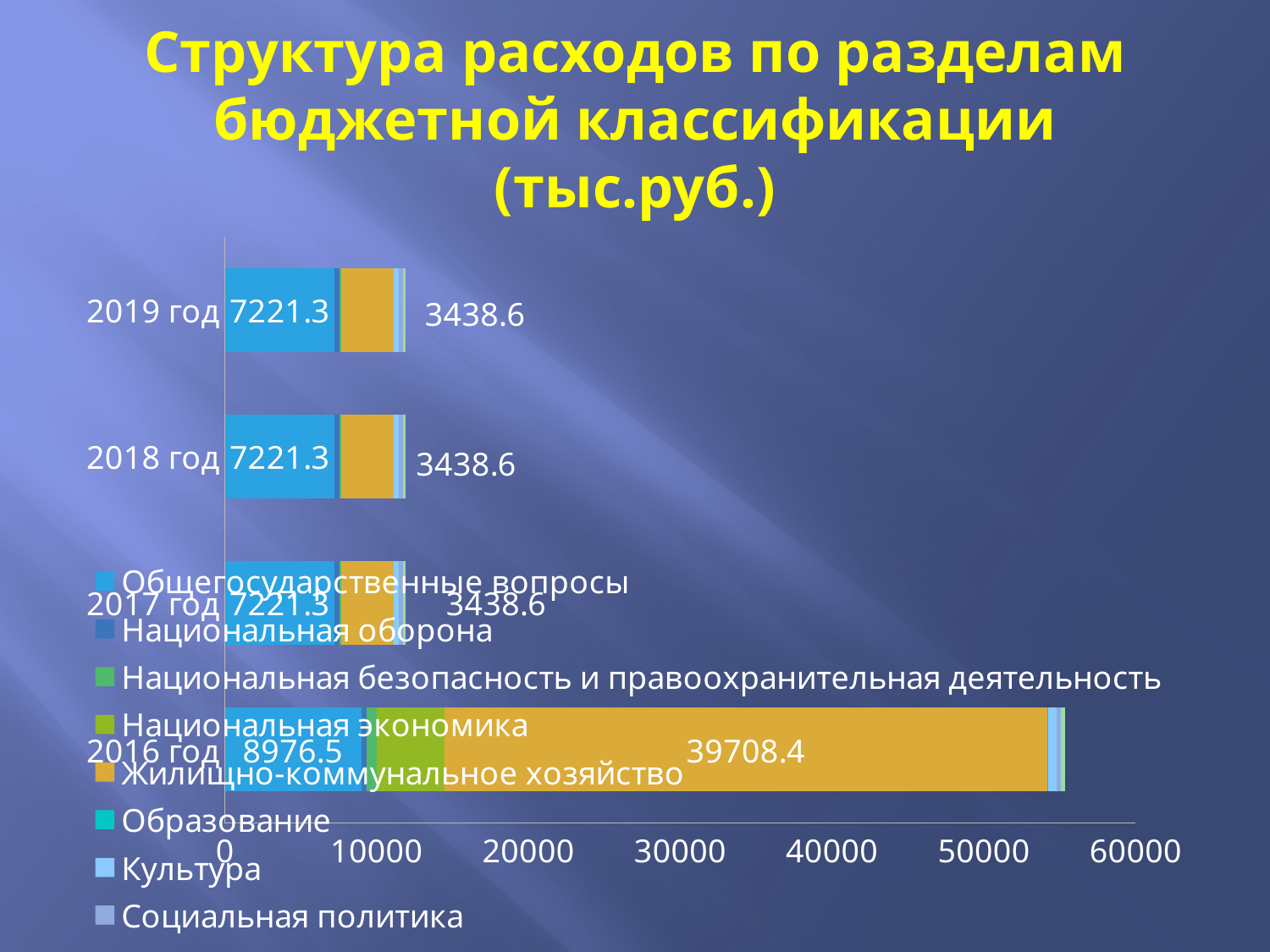
Is the total bar length for 2016 год greater or less than 50000? greater What is the value of Общегосударственные вопросы for 2019 год? 7221.3 What is the value of Жилищно-коммунальное хозяйство for 2016 год? 39708.4 What is the title of the chart? Структура расходов по разделам бюджетной классификации (тыс.руб.) What is the value of Общегосударственные вопросы for 2016 год? 8976.5 Which year has the larger value for Общегосударственные вопросы, 2016 год or 2018 год? 2016 год Is the total bar length for 2019 год greater or less than 20000? less What type of chart is shown on the slide? bar chart What is the difference between the Общегосударственные вопросы values for 2016 год and 2019 год? 1755.2 Which year has the longest total bar? 2016 год How many series does the legend list? 8 How many years (categories) are plotted on the chart? 4